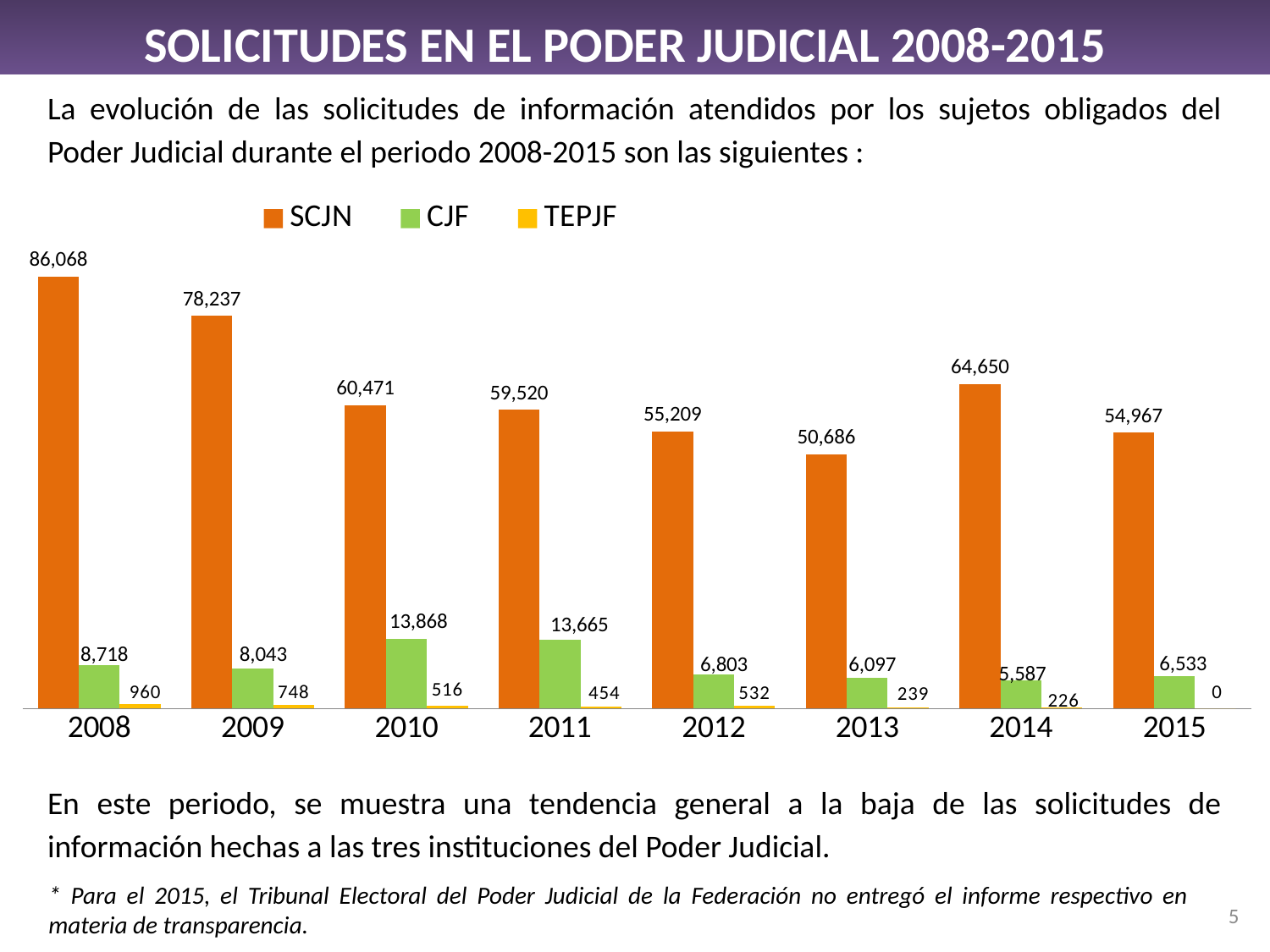
What kind of chart is shown on the slide? bar chart How many years are shown on the x axis? 8 What is the TEPJF value for 2013? 239 What is the difference between the SCJN values for 2008 and 2009? 7,831 In which year is the SCJN value lowest? 2013 How many series does the legend list? 3 Does the TEPJF value rise or fall from 2008 to 2015? fall In which year is the CJF value highest? 2010 What is the TEPJF value for 2015? 0 What is the SCJN value for 2008? 86,068 Which is larger, the SCJN value for 2014 or for 2015? 2014 What is the CJF value for 2010? 13,868